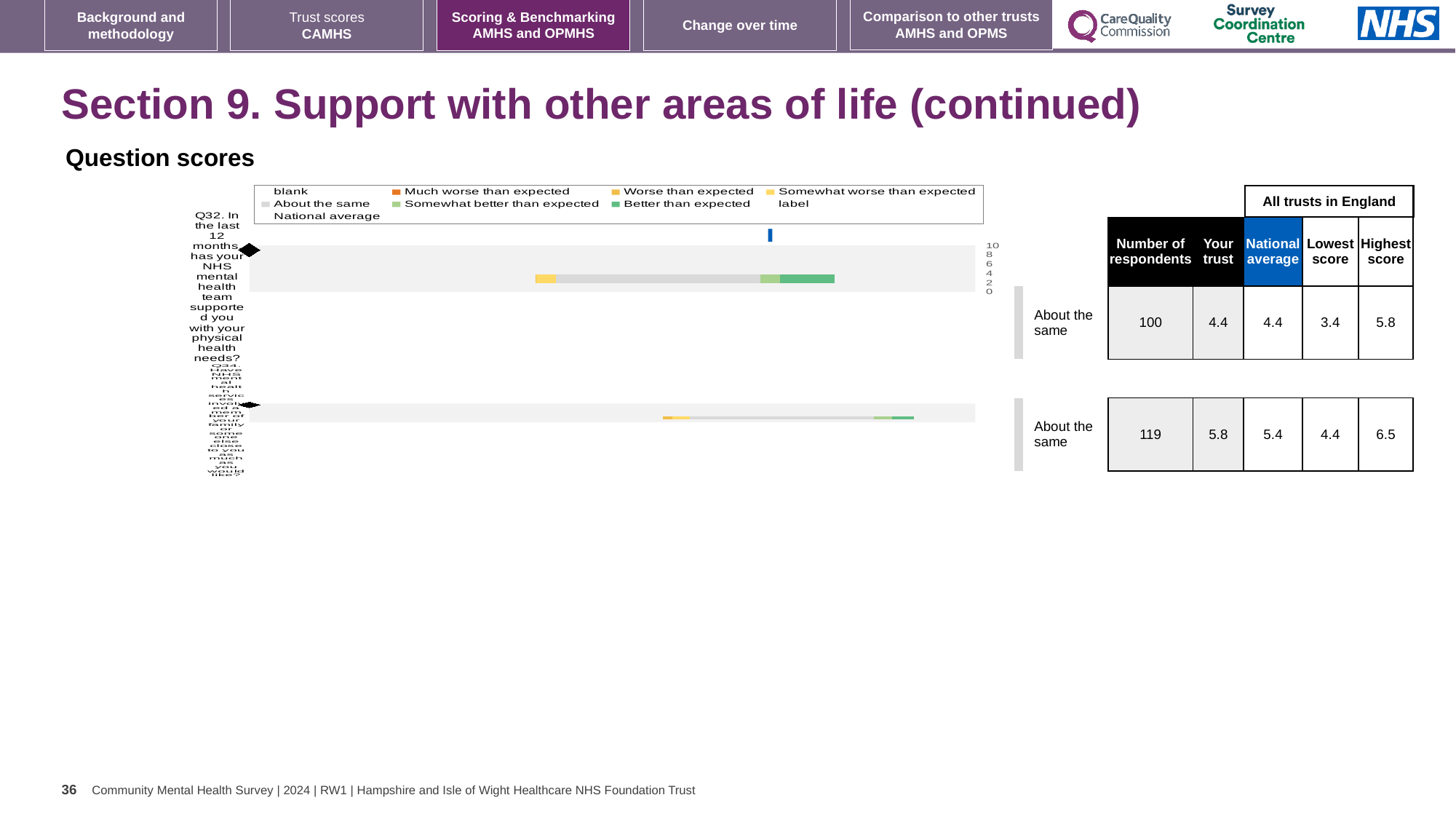
For the second (lower) question, which is larger: the 'Your trust' score or the 'National average'? Your trust In the chart legend, what colour represents 'Much worse than expected'? orange What is the difference between the highest score and the lowest score for Q32 in the table? 2.4 How many more respondents answered the second (lower) question than Q32? 19 According to the table beside the chart, what is the lowest score across all trusts in England for Q32? 3.4 According to the table beside the chart, what is the highest score across all trusts in England for the second (lower) question? 6.5 According to the table beside the chart, how many respondents answered Q32 (support with physical health needs)? 100 How many survey questions are plotted as bars in the question scores chart? 2 According to the table beside the chart, what is the 'Your trust' score for Q32 (support with physical health needs)? 4.4 What benchmark category is shown next to the bar for Q32? About the same In the chart legend, what colour represents 'Better than expected'? green What kind of chart is used to show the question scores on this slide? bar chart